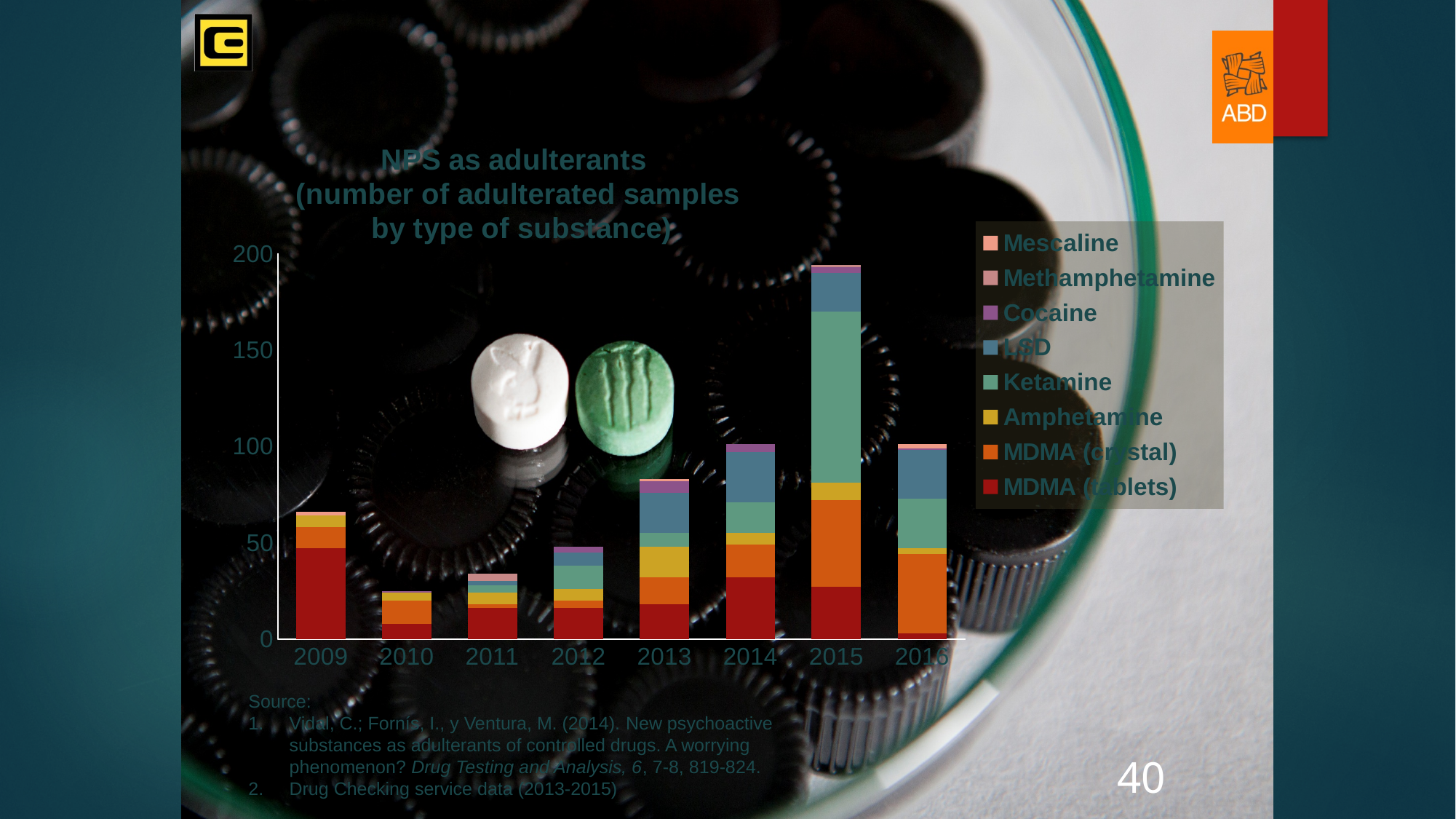
Which year has a larger total of adulterated samples, 2009 or 2010? 2009 Is the total for 2009 greater or less than 50? greater How many years are shown along the x axis of the chart? 8 Is the total for 2015 greater or less than 150? greater Is the total for 2013 greater or less than 100? less Between 2010 and 2015, do the yearly totals generally rise or fall? rise Which year has the highest total number of adulterated samples? 2015 What kind of chart is shown on the slide? Stacked bar chart Which substance is shown at the bottom of each stacked bar? MDMA (tablets) Which year has the lowest total number of adulterated samples? 2010 How many substances does the chart's legend list? 8